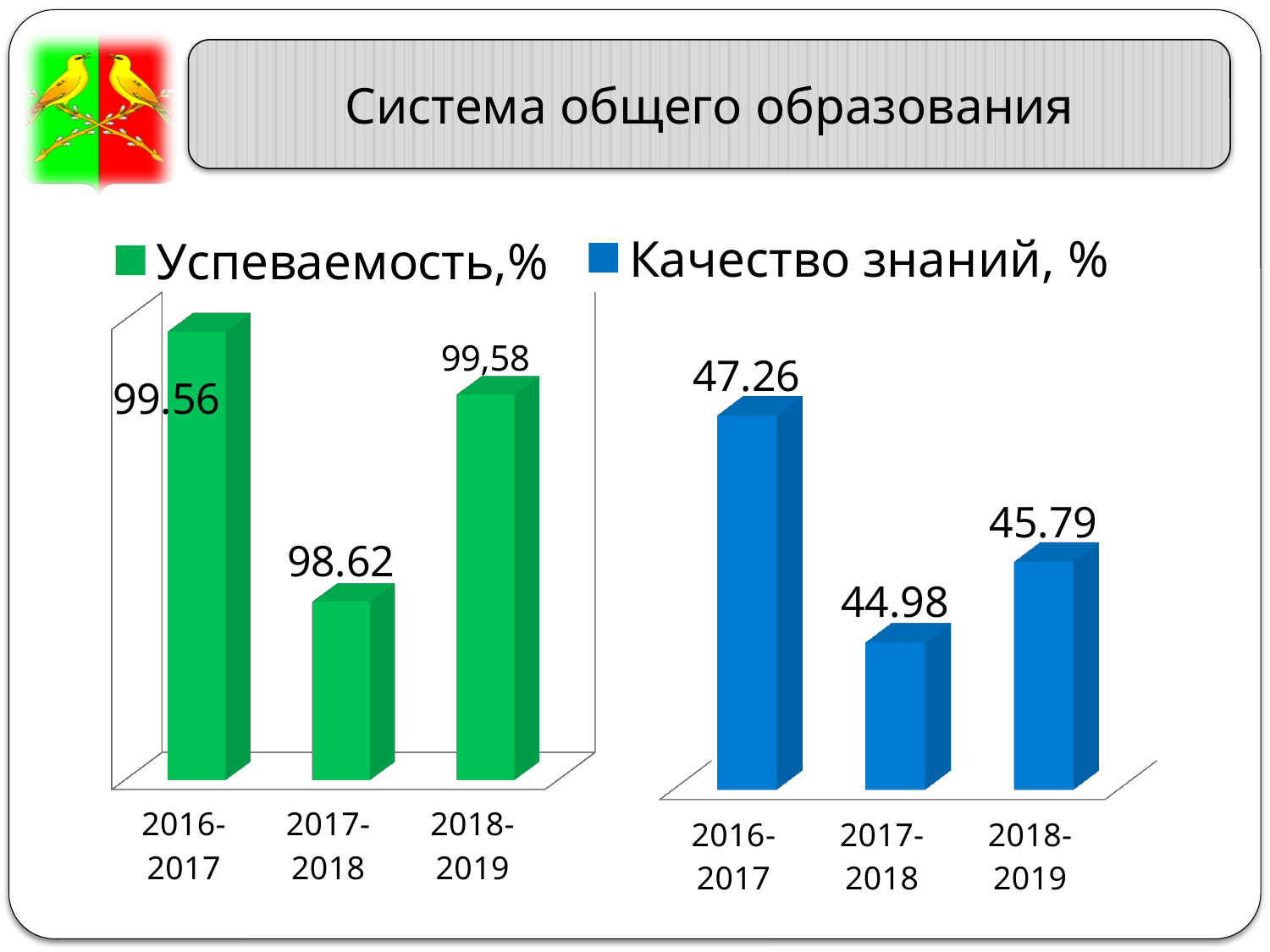
In the Успеваемость,% chart, what is the value for 2017-2018? 98.62 How many periods are shown on the x axis of the Качество знаний, % chart? 3 In the Качество знаний, % chart, which period has the highest value? 2016-2017 In the Качество знаний, % chart, what is the value for 2018-2019? 45.79 In the Качество знаний, % chart, what is the difference between the 2016-2017 and 2017-2018 values? 2.28 In the Качество знаний, % chart, which period has the lowest value? 2017-2018 What type of chart is used on this slide? Bar chart In the Качество знаний, % chart, which is larger: the value for 2017-2018 or the value for 2018-2019? 2018-2019 In the Успеваемость,% chart, which period has the lowest value? 2017-2018 In the Успеваемость,% chart, what is the value for 2016-2017? 99.56 In the Качество знаний, % chart, what is the value for 2016-2017? 47.26 In the Успеваемость,% chart, what is the difference between the 2016-2017 and 2017-2018 values? 0.94